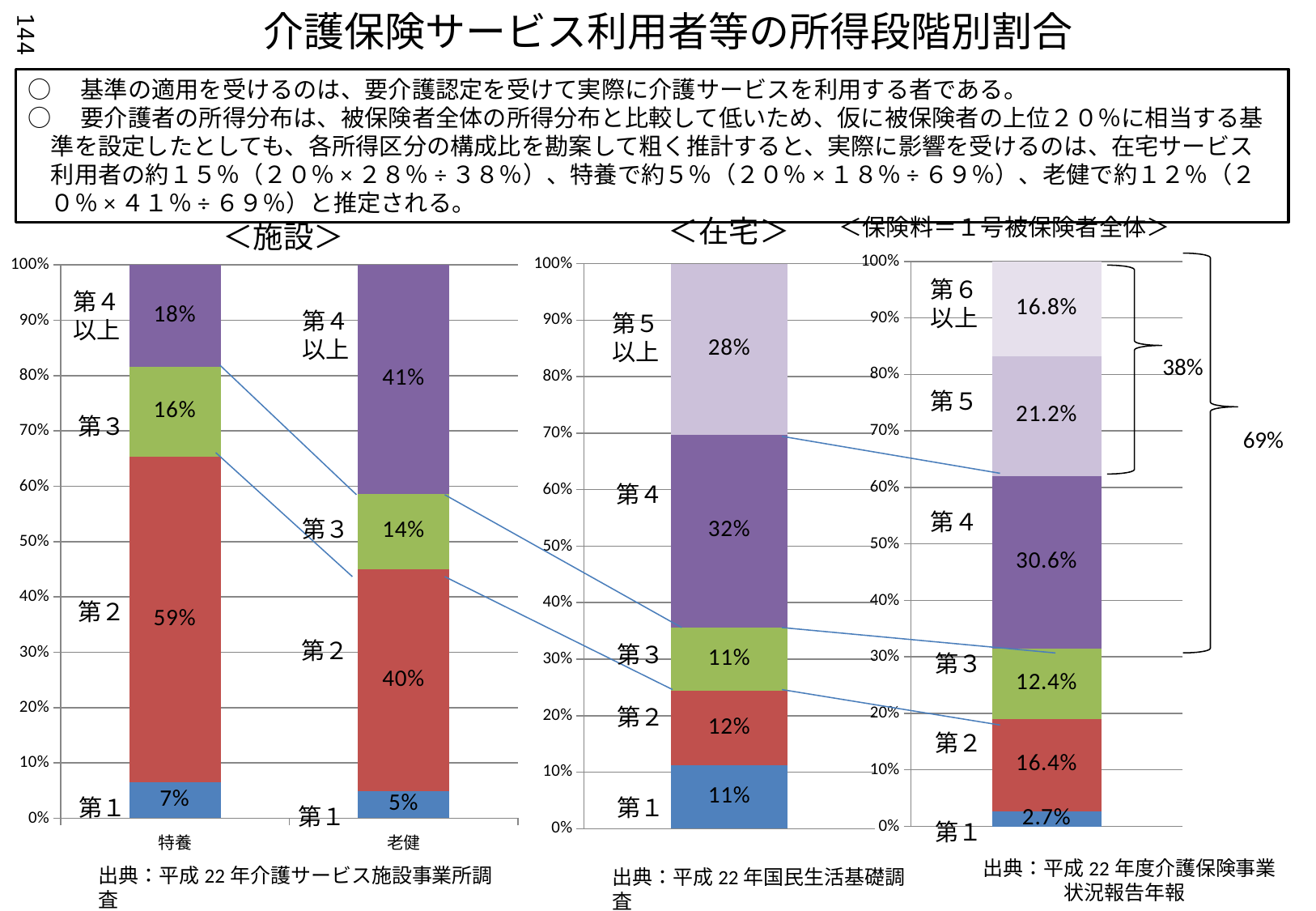
＜保険料＝１号被保険者全体＞のグラフで、最も割合が小さい所得段階はどれですか？ 第１ ＜施設＞のグラフで、老健の第４以上の割合はいくらですか？ 41% ＜施設＞のグラフには、いくつの棒（カテゴリ）がありますか？ 2 ＜保険料＝１号被保険者全体＞のグラフで、第５と第６以上の割合の合計はいくらですか？ 38% ＜施設＞のグラフで、第３の割合は特養と老健のどちらが大きいですか？ 特養 ＜施設＞のグラフで、特養の第１の割合と老健の第１の割合の差はいくらですか？ 2% ＜在宅＞のグラフで、第４の割合はいくらですか？ 32% このスライドのグラフはどの種類のグラフですか？ 積み上げ棒グラフ ＜在宅＞のグラフで、最も割合が大きい所得段階はどれですか？ 第４ ＜施設＞のグラフで、特養の第２の割合はいくらですか？ 59% ＜保険料＝１号被保険者全体＞のグラフで、第１の割合はいくらですか？ 2.7% ＜在宅＞のグラフで、第４と第５以上の割合の合計はいくらですか？ 60%